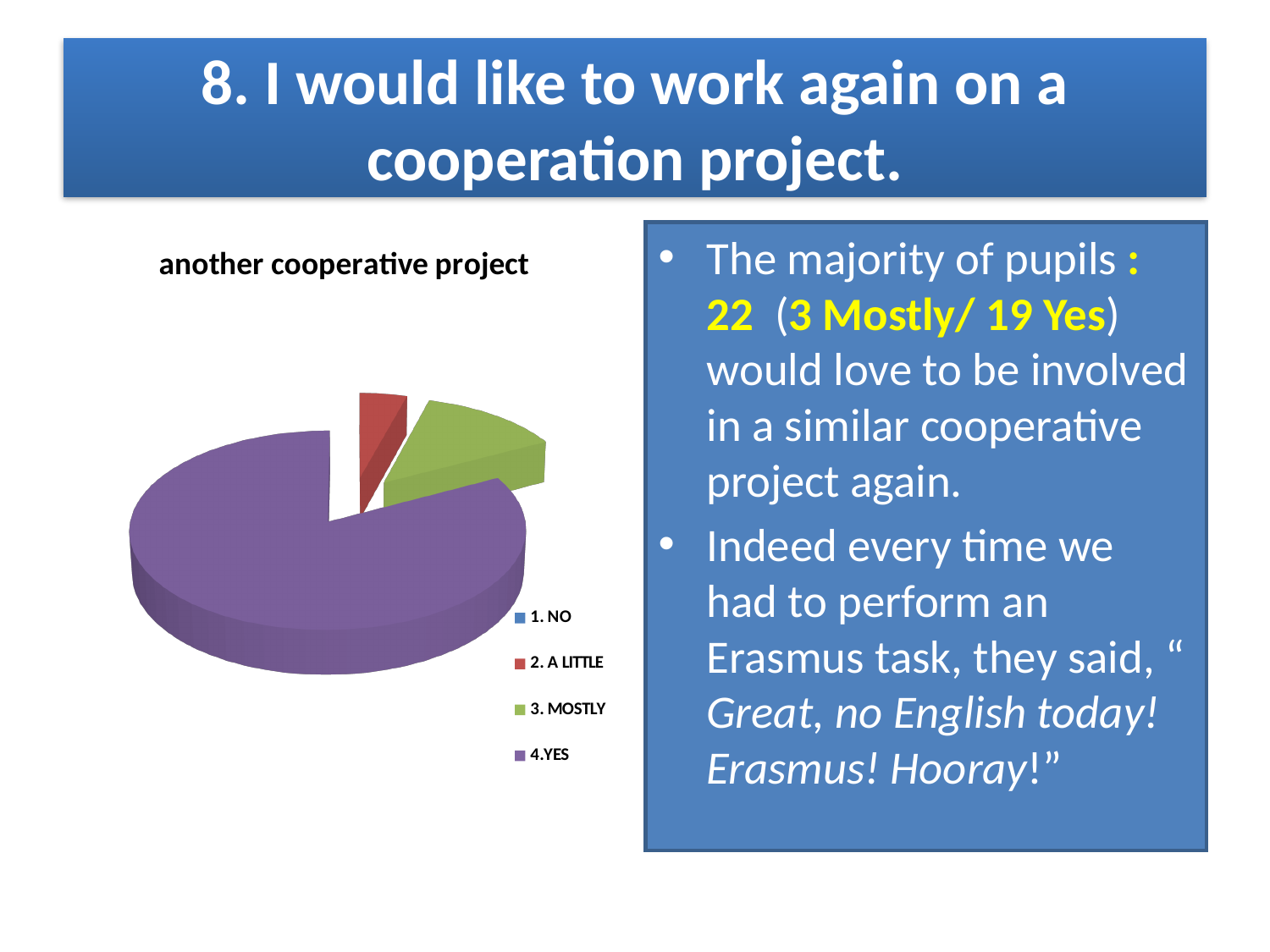
Which slice is larger, 3. MOSTLY or 2. A LITTLE? 3. MOSTLY Which colour represents the 4.YES category in the chart? purple What is the title of the chart? another cooperative project What kind of chart is shown on the slide? pie chart How many entries does the chart's legend list? 4 Which category has the largest slice of the pie? 4.YES Which slice is larger, 4.YES or 3. MOSTLY? 4.YES Does the 4.YES slice take up more or less than half of the pie? more